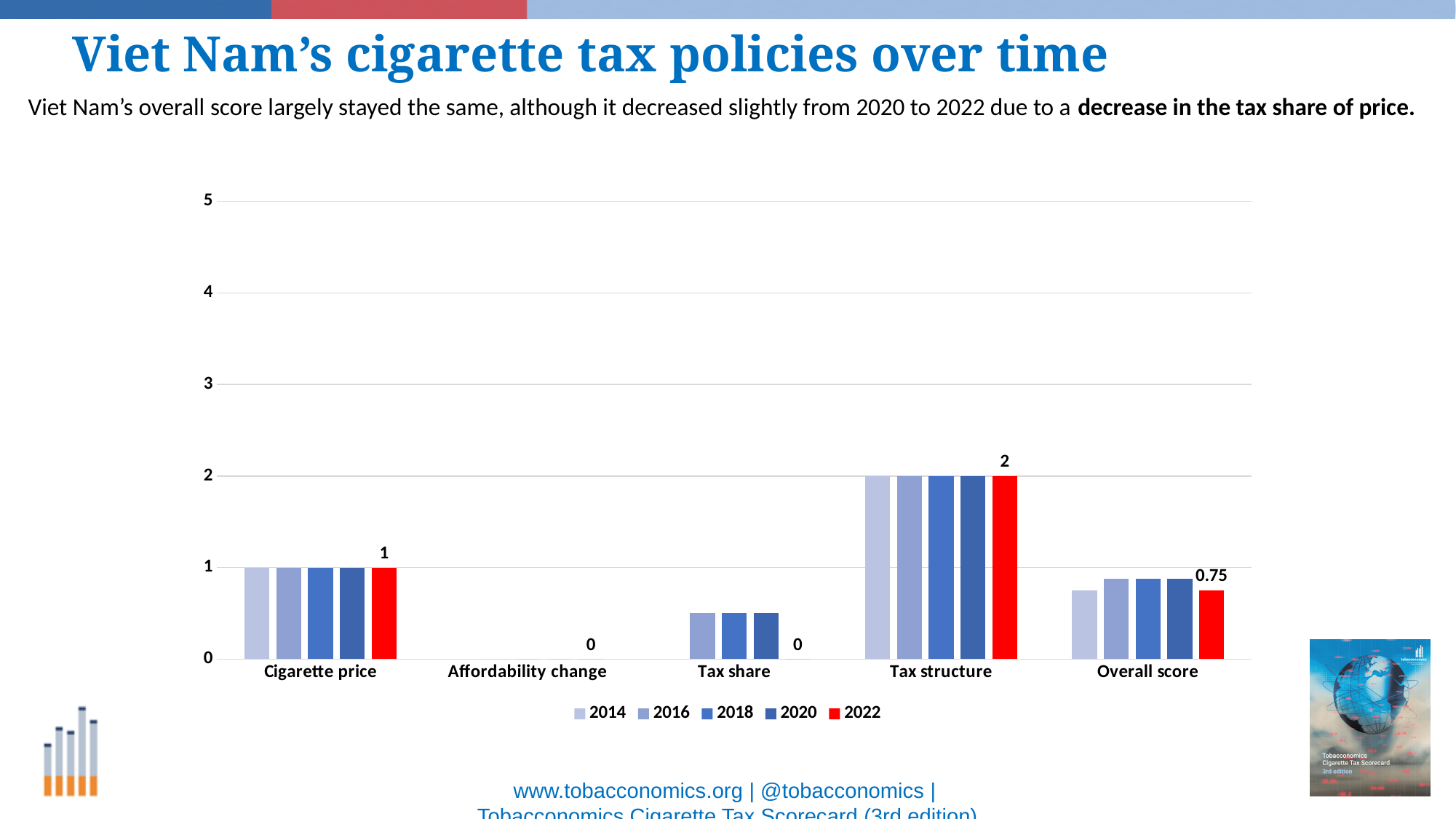
What kind of chart is shown on the slide? bar chart Which colour represents the 2022 series in the legend? red What is the 2014 value for Tax structure? 2 How many categories are shown on the x axis? 5 What is the difference between the 2022 values for Tax structure and Overall score? 1.25 What is the 2022 value for Tax structure? 2 How many series does the legend list? 5 Which category has the highest 2022 value? Tax structure What is the 2022 value for Overall score? 0.75 Is the 2014 value for Tax share greater or less than 1? less What is the 2022 value for Cigarette price? 1 What is the 2022 value for Tax share? 0